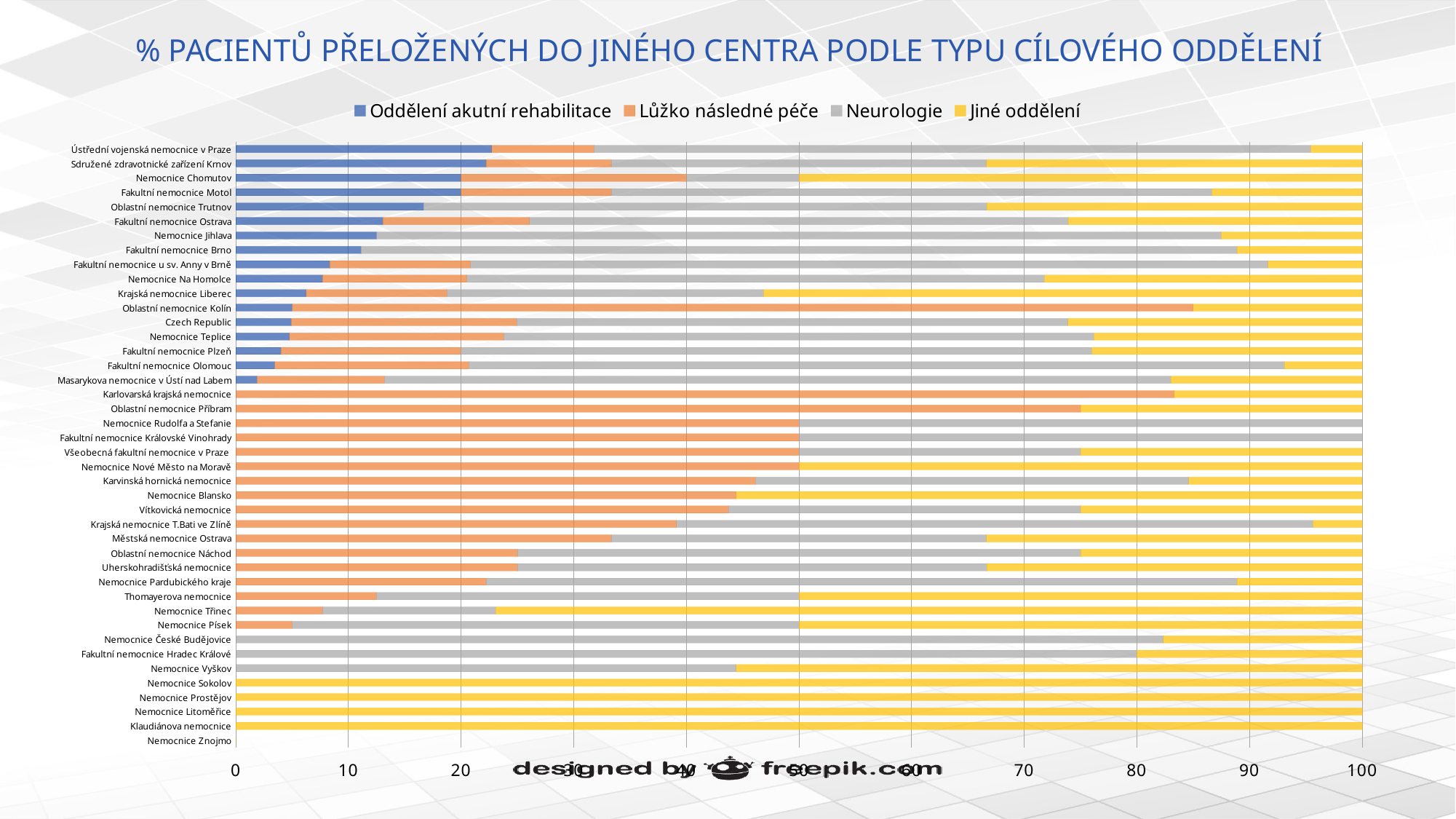
What is the title of the chart? % PACIENTŮ PŘELOŽENÝCH DO JINÉHO CENTRA PODLE TYPU CÍLOVÉHO ODDĚLENÍ Is the Neurologie value for Nemocnice Vyškov greater or less than 50? less Is the Oddělení akutní rehabilitace value for Ústřední vojenská nemocnice v Praze greater or less than 20? greater Is the Lůžko následné péče value for Nemocnice Písek greater or less than 10? less How many hospitals (categories) are listed on the y axis of the chart? 42 What kind of chart is shown on the slide? Stacked bar chart Which hospital listed on the y axis has no bar plotted at all? Nemocnice Znojmo Which has the larger Oddělení akutní rehabilitace segment, Oblastní nemocnice Trutnov or Krajská nemocnice Liberec? Oblastní nemocnice Trutnov Which has the larger Lůžko následné péče segment, Nemocnice Chomutov or Fakultní nemocnice Motol? Nemocnice Chomutov How many series does the legend list? 4